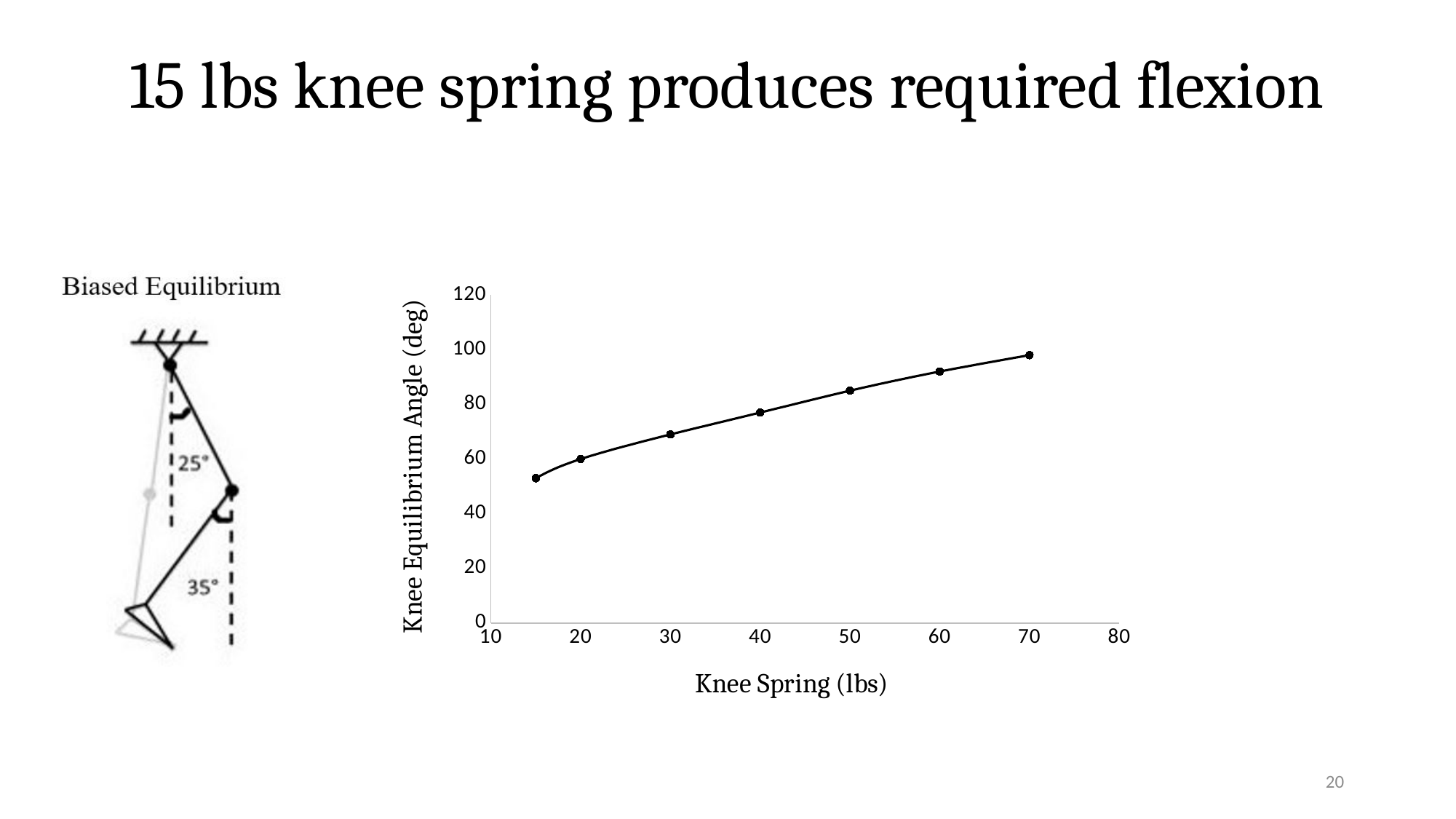
What is the title of the x axis of the chart? Knee Spring (lbs) How many data points are plotted on the chart? 7 At which knee spring value is the knee equilibrium angle lowest? 15 What kind of chart is shown on the slide? line chart Which has the larger knee equilibrium angle: a 20 lbs knee spring or a 50 lbs knee spring? 50 lbs knee spring Is the knee equilibrium angle at a 40 lbs knee spring greater or less than 60? greater What is the title of the y axis of the chart? Knee Equilibrium Angle (deg) At which knee spring value is the knee equilibrium angle highest? 70 Is the knee equilibrium angle at a 70 lbs knee spring greater or less than 80? greater Is the knee equilibrium angle at a 15 lbs knee spring greater or less than 60? less Does the knee equilibrium angle rise or fall as the knee spring increases from 15 to 70 lbs? rise